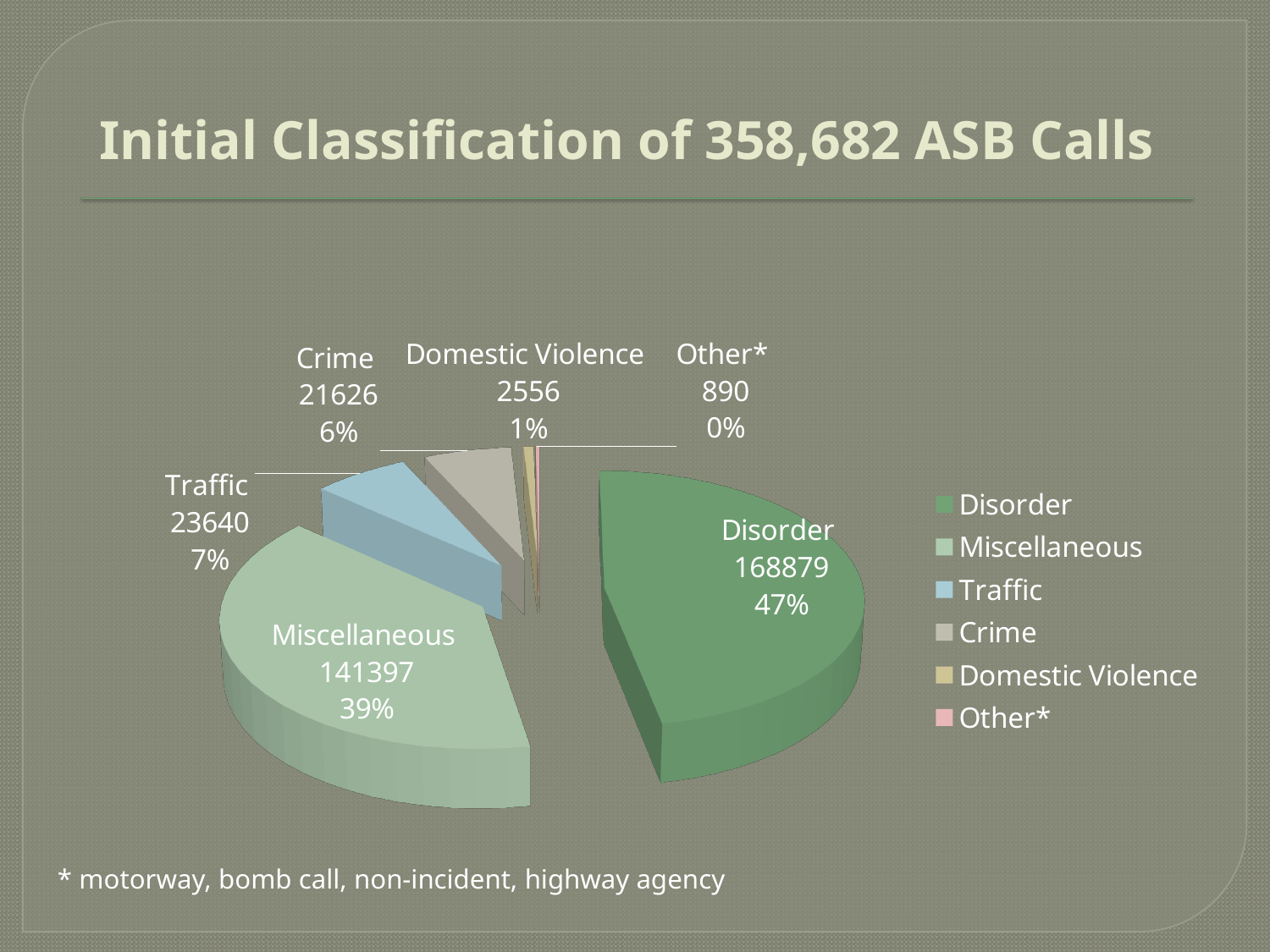
Which has more calls, Traffic or Crime? Traffic Which category has the smallest slice of the pie? Other* What share of the pie does Crime represent? 6% What is the title of the chart slide? Initial Classification of 358,682 ASB Calls How many calls were classified as Traffic? 23640 How many calls were classified as Disorder? 168879 What percentage of calls were classified as Miscellaneous? 39% How many calls were classified as Domestic Violence? 2556 What kind of chart is shown on the slide? pie chart What is the difference in calls between Disorder and Miscellaneous? 27482 How many categories does the legend list? 6 Which category has the largest slice of the pie? Disorder